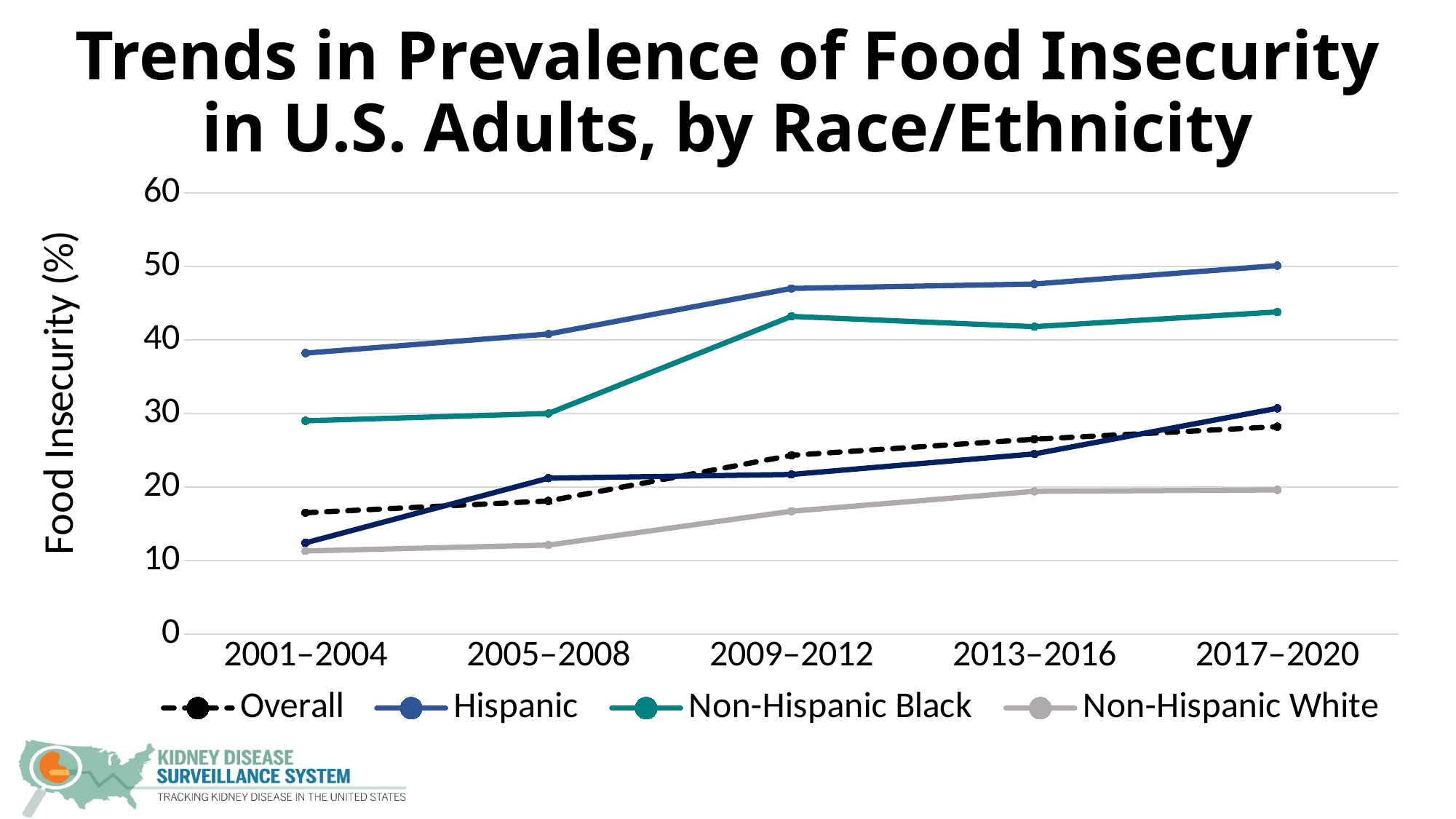
Does the Hispanic line rise or fall from 2001–2004 to 2017–2020? rise How many series does the legend list? 4 Is the value for Non-Hispanic White in 2009–2012 greater or less than 20? less Which legend series has the lowest food insecurity in 2001–2004? Non-Hispanic White How many time periods are shown on the x axis? 5 Is the value for Non-Hispanic Black in 2009–2012 greater or less than 40? greater Which is larger in 2009–2012, Non-Hispanic Black or Non-Hispanic White? Non-Hispanic Black What kind of chart is shown on the slide? line chart Is the value for Hispanic in 2001–2004 greater or less than 30? greater Which legend series has the highest food insecurity in 2017–2020? Hispanic What is the label of the y axis? Food Insecurity (%)